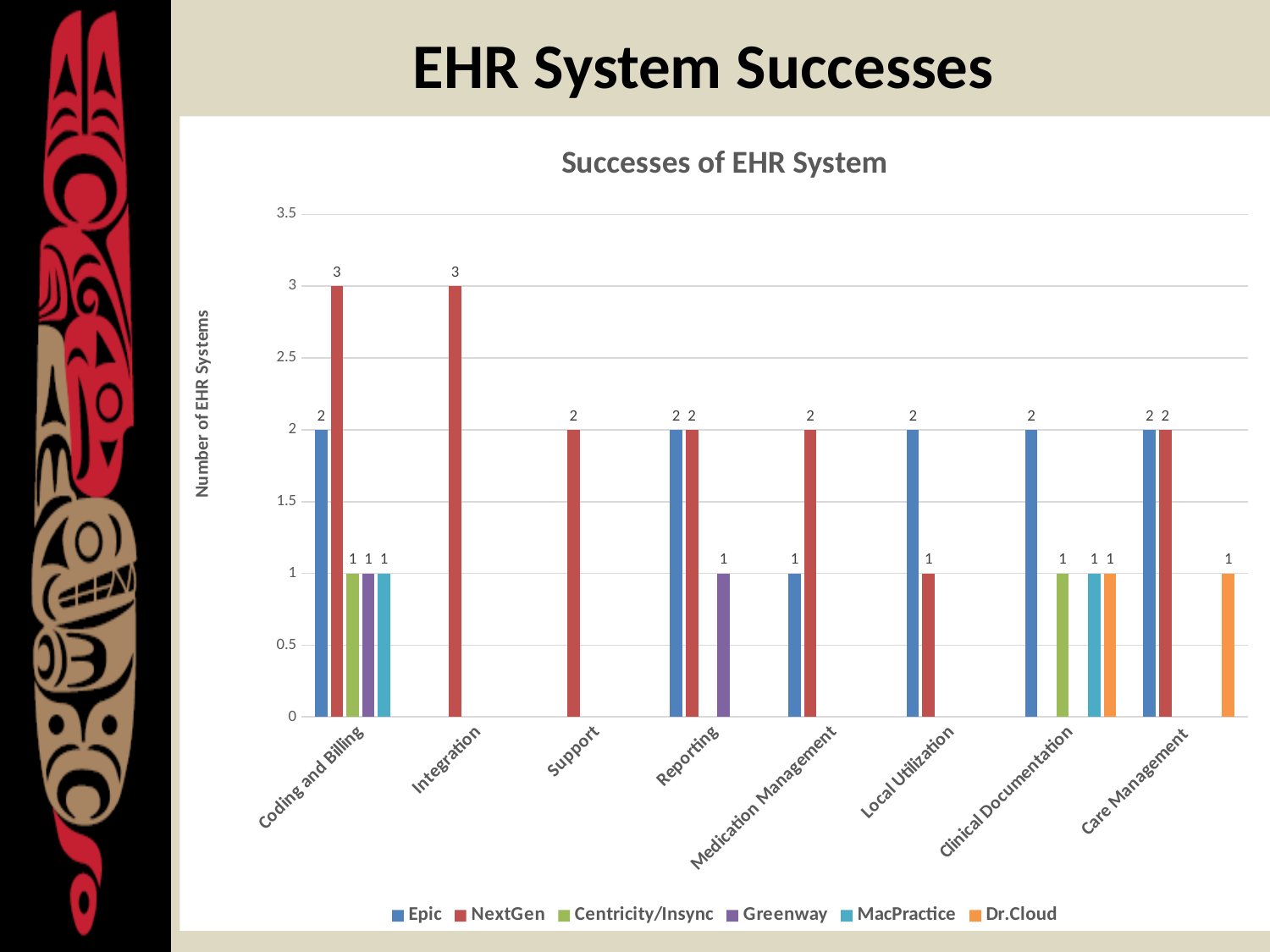
What is the difference between the NextGen and Epic values in the Coding and Billing category? 1 What is the value for Dr.Cloud in the Care Management category? 1 What is the value for NextGen in the Support category? 2 What is the value for Epic in the Medication Management category? 1 Which is larger in the Local Utilization category, the Epic value or the NextGen value? Epic What is the title of the chart? Successes of EHR System What is the label of the vertical axis? Number of EHR Systems What type of chart is shown on the slide? Bar chart How many series does the legend list? 6 What is the value for NextGen in the Coding and Billing category? 3 How many categories are shown on the x axis? 8 Which series has the highest value in the Coding and Billing category? NextGen